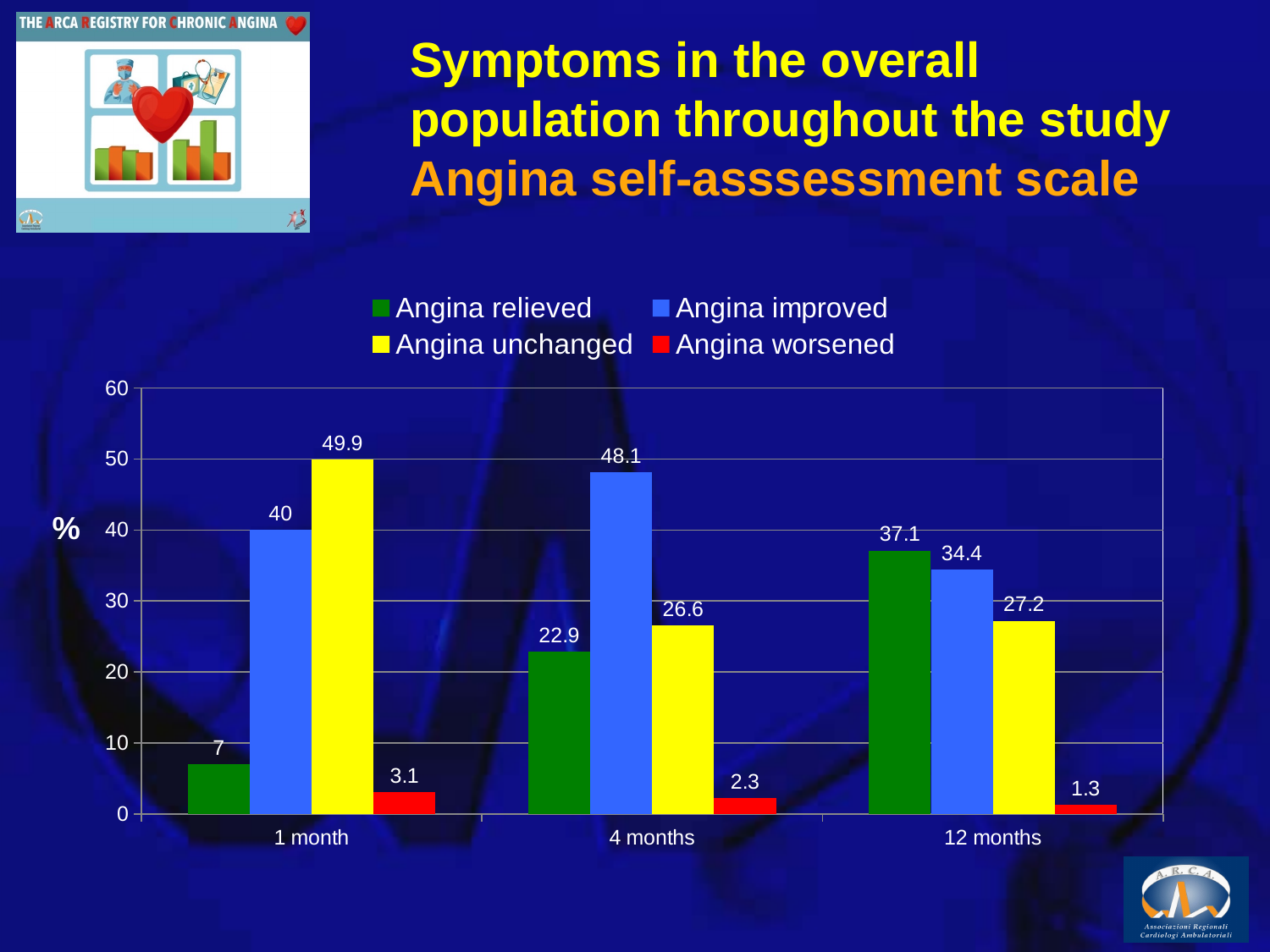
What is the difference between Angina improved at 4 months and Angina improved at 12 months? 13.7 Does the value for Angina unchanged rise or fall from 1 month to 12 months? Fall At which time point is the value for Angina relieved highest? 12 months What is the value for Angina worsened at 12 months? 1.3 What is the value for Angina relieved at 1 month? 7 How many time points are shown on the x axis? 3 Which is larger at 12 months: Angina relieved or Angina unchanged? Angina relieved How many series does the legend list? 4 What kind of chart is shown on the slide? Bar chart What is the value for Angina improved at 4 months? 48.1 At which time point is the value for Angina worsened lowest? 12 months What is the value for Angina unchanged at 1 month? 49.9